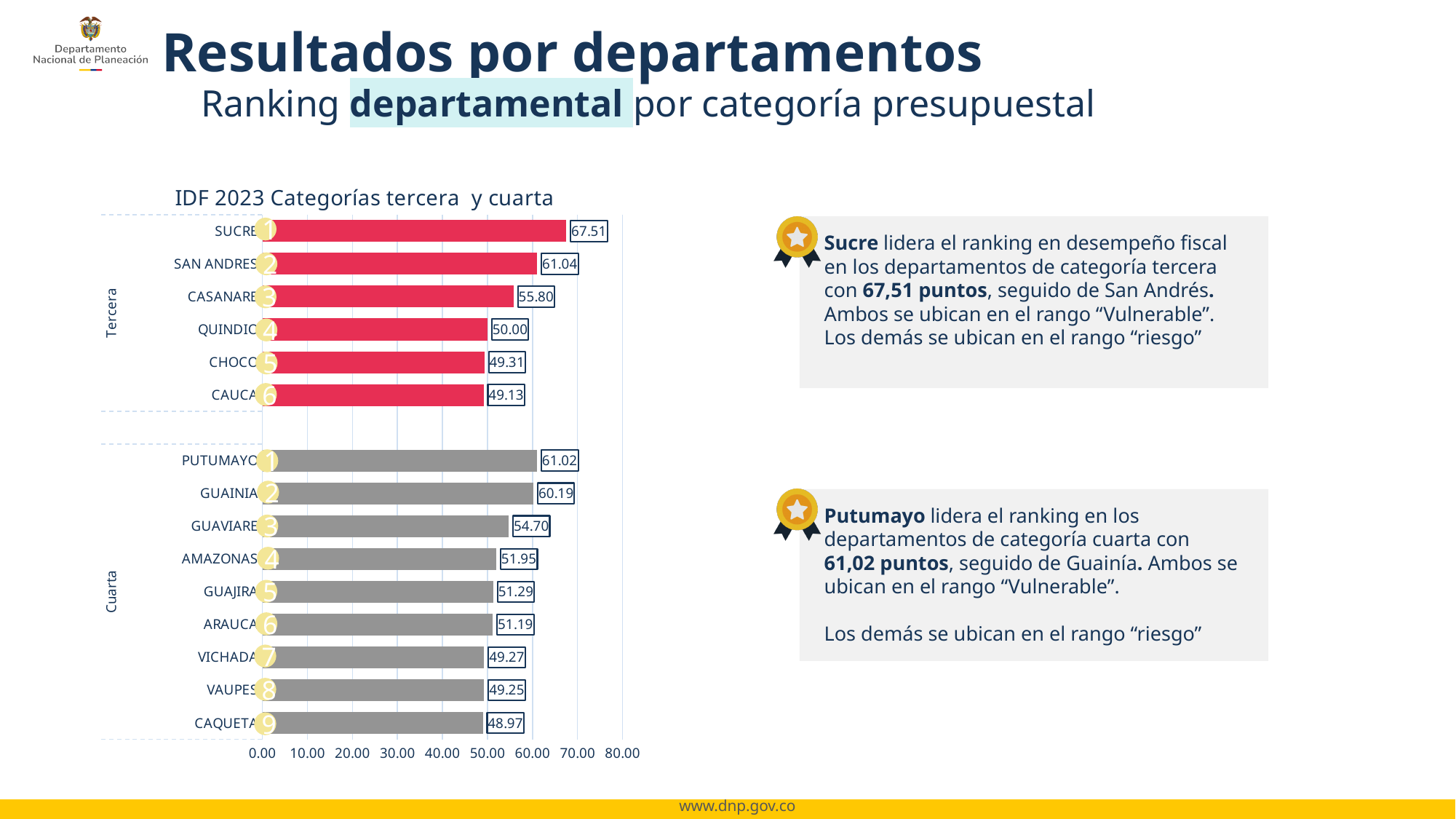
What is the title of the chart on the slide? IDF 2023 Categorías tercera y cuarta What is the value for PUTUMAYO in the IDF 2023 chart? 61.02 What is the value for SUCRE in the IDF 2023 chart? 67.51 Is the value for CAQUETA greater or less than 50.00? less What is the value for CASANARE in the IDF 2023 chart? 55.80 What kind of chart is shown on the slide? bar chart What is the difference between the values for SUCRE and SAN ANDRES? 6.47 Which department has the lowest value in the IDF 2023 chart? CAQUETA Which has a larger value, QUINDIO or AMAZONAS? AMAZONAS What is the difference between the values for PUTUMAYO and GUAINIA? 0.83 Which department has the highest value in the IDF 2023 chart? SUCRE How many departments are shown in the Cuarta group of the chart? 9